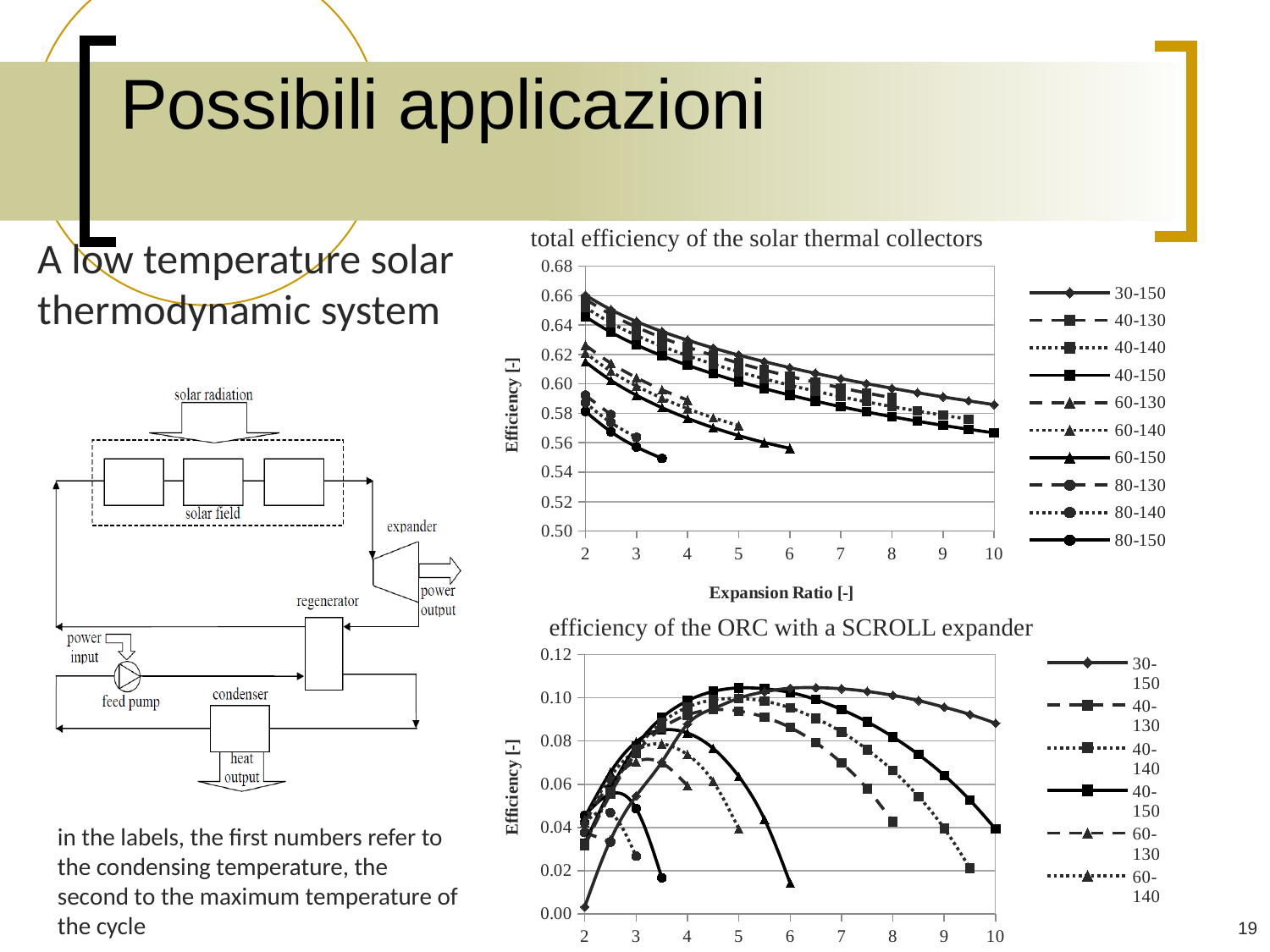
In the 'efficiency of the ORC with a SCROLL expander' chart, is the value of the 40-150 series at expansion ratio 10 greater or less than 0.06? less In the 'total efficiency of the solar thermal collectors' chart, is the value of the 80-150 series at expansion ratio 3.5 greater or less than 0.56? less In the 'efficiency of the ORC with a SCROLL expander' chart, is the value of the 30-150 series at expansion ratio 10 greater or less than 0.08? greater What is the title of the lower chart on the slide? efficiency of the ORC with a SCROLL expander What is the x-axis label of the 'total efficiency of the solar thermal collectors' chart? Expansion Ratio [-] How many series does the legend of the 'total efficiency of the solar thermal collectors' chart list? 10 In the 'total efficiency of the solar thermal collectors' chart, does the 30-150 series rise or fall as the expansion ratio increases? fall What kind of chart is the 'total efficiency of the solar thermal collectors' chart? line chart In the 'total efficiency of the solar thermal collectors' chart, does the 60-150 series rise or fall as the expansion ratio increases? fall In the 'total efficiency of the solar thermal collectors' chart, at expansion ratio 10, which series is higher: 30-150 or 40-150? 30-150